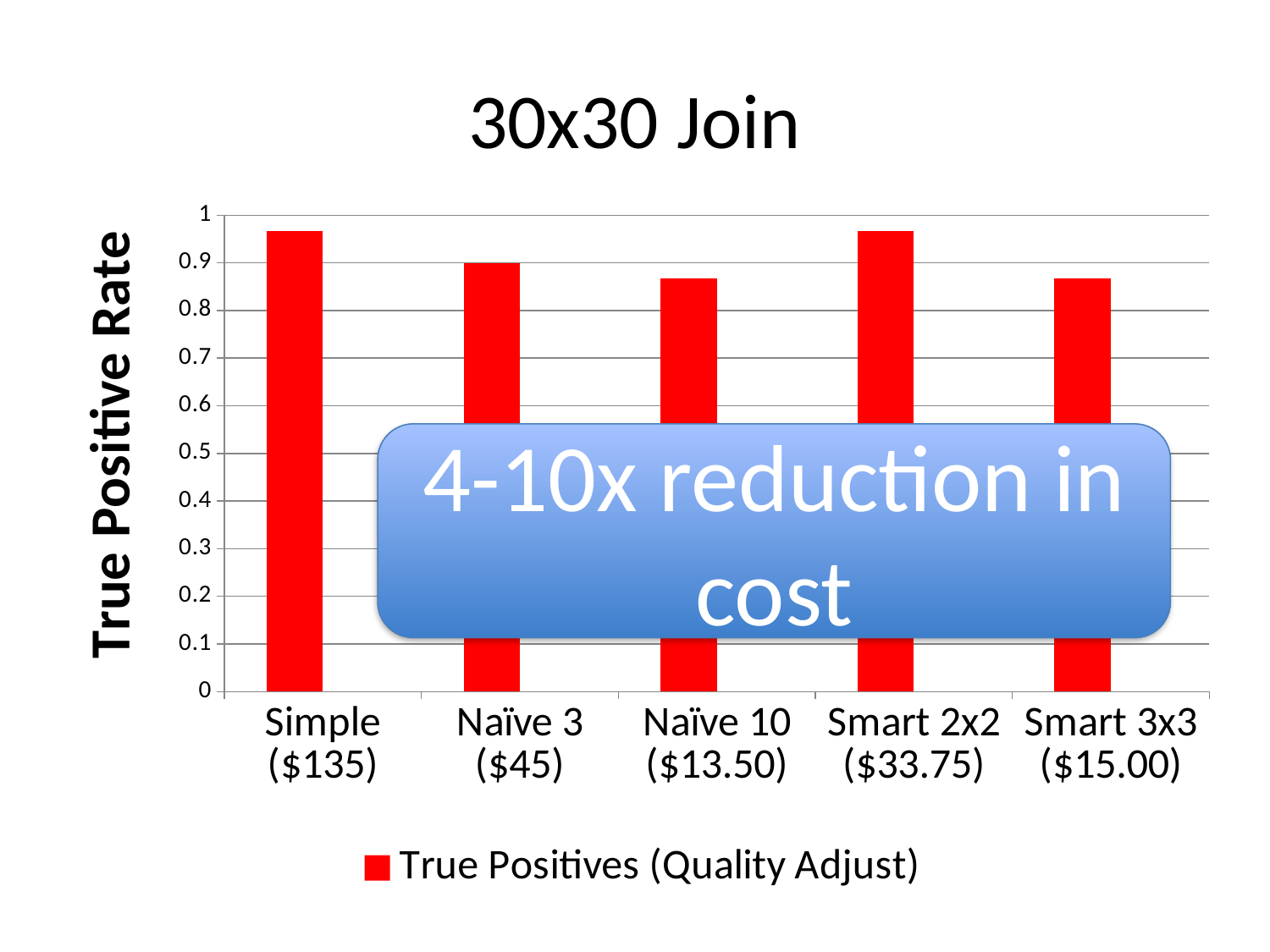
What is the true positive rate for Naïve 3 ($45)? 0.9 What is the label of the y axis? True Positive Rate Is the value for Smart 2x2 ($33.75) greater or less than 0.9? greater Is the value for Simple ($135) greater or less than 0.9? greater How many series does the legend list? 1 What is the title of the chart? 30x30 Join Which has a higher true positive rate, Simple ($135) or Naïve 10 ($13.50)? Simple ($135) Which has a higher true positive rate, Naïve 3 ($45) or Smart 3x3 ($15.00)? Naïve 3 ($45) How many categories are plotted along the x axis? 5 Is the value for Smart 3x3 ($15.00) greater or less than 0.8? greater What type of chart is shown on the slide? bar chart